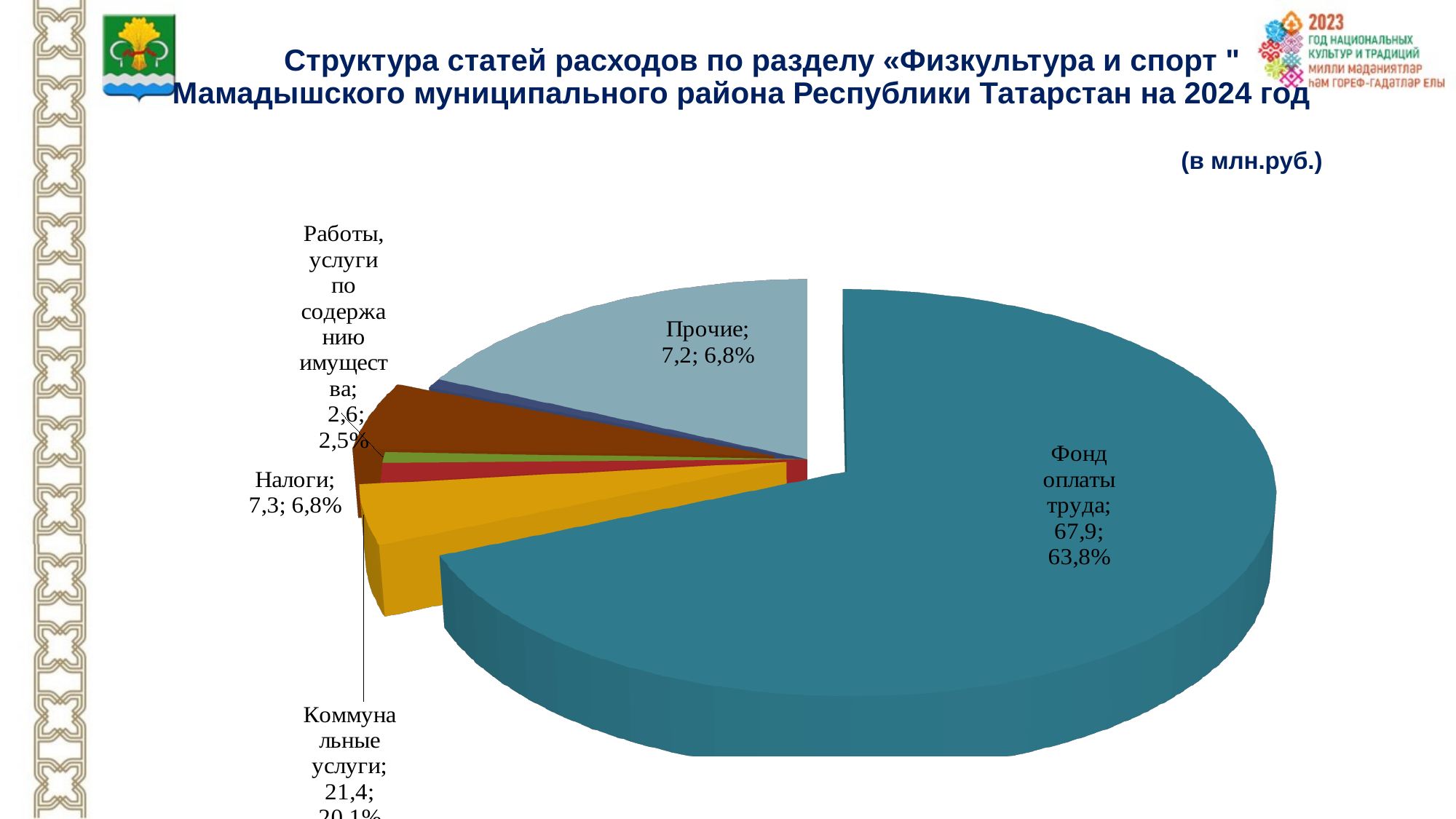
What is the value for Налоги? 7,3 What kind of chart is shown on the slide? pie chart What is the value for Фонд оплаты труда? 67,9 What is the value for Прочие? 7,2 Which is larger, the value for Коммунальные услуги or the value for Налоги? Коммунальные услуги What is the difference between the values for Фонд оплаты труда and Коммунальные услуги? 46,5 What is the value for Работы, услуги по содержанию имущества? 2,6 What share of the pie does Фонд оплаты труда represent? 63,8% Which category has the largest slice of the pie? Фонд оплаты труда What share of the pie does Работы, услуги по содержанию имущества represent? 2,5% What is the value for Коммунальные услуги? 21,4 In what units are the chart values given, according to the slide? млн.руб.